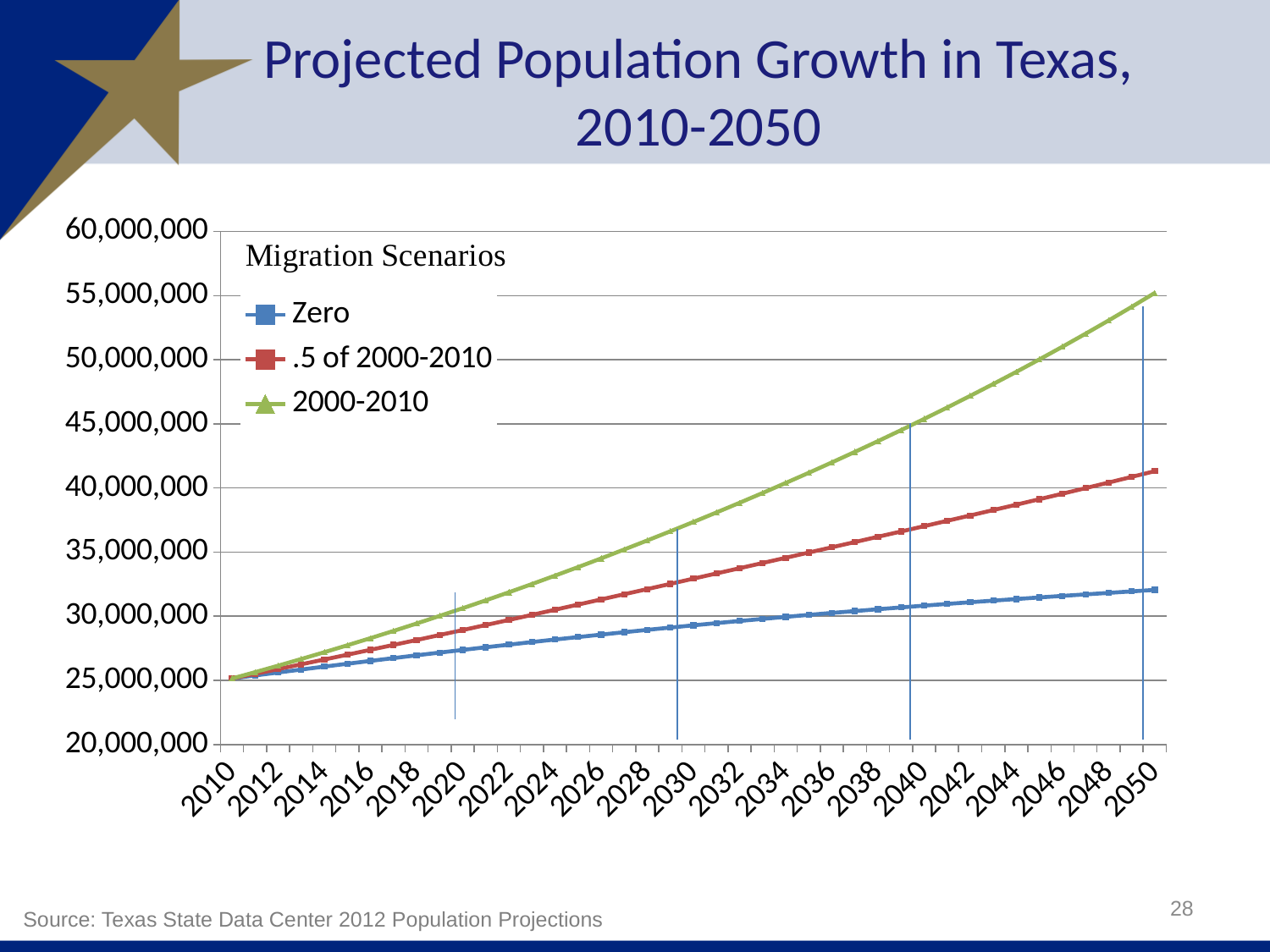
What heading appears above the legend entries? Migration Scenarios Is the value for the Zero series in 2030 greater or less than 30,000,000? less Is the value for the .5 of 2000-2010 series in 2050 greater or less than 35,000,000? greater Which series has the highest value in 2050? 2000-2010 How many series does the legend list? 3 Do the values for the 2000-2010 series rise or fall from 2010 to 2050? Rise How many year labels are shown on the x axis? 21 In 2040, which series has the larger value: Zero or .5 of 2000-2010? .5 of 2000-2010 What is the title of the chart? Projected Population Growth in Texas, 2010-2050 Which series has the lowest value in 2050? Zero What kind of chart is shown on the slide? Line chart Is the value for the 2000-2010 series in 2050 greater or less than 50,000,000? greater